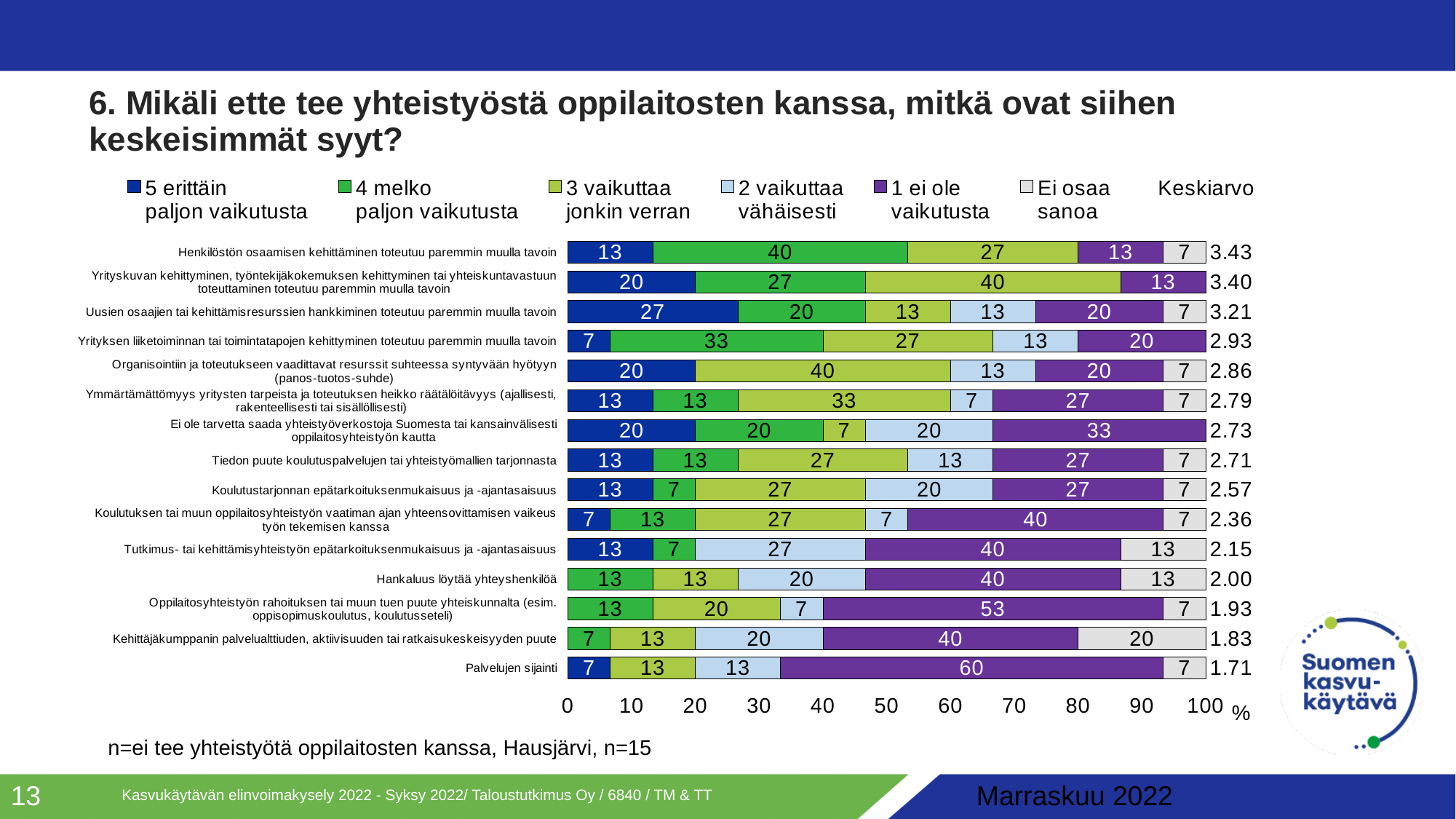
What is the difference between the Keskiarvo of 'Henkilöstön osaamisen kehittäminen toteutuu paremmin muulla tavoin' and that of 'Palvelujen sijainti'? 1.72 Which category has the highest Keskiarvo value? Henkilöstön osaamisen kehittäminen toteutuu paremmin muulla tavoin Which legend entry is shown in dark blue? 5 erittäin paljon vaikutusta How many categories (reasons) are plotted in the chart? 15 What is the value of '5 erittäin paljon vaikutusta' for 'Uusien osaajien tai kehittämisresurssien hankkiminen toteutuu paremmin muulla tavoin'? 27 Which category has the lowest Keskiarvo value? Palvelujen sijainti What kind of chart is shown on the slide? Stacked horizontal bar chart What is the value of '1 ei ole vaikutusta' for 'Palvelujen sijainti'? 60 What is the value of '4 melko paljon vaikutusta' for 'Henkilöstön osaamisen kehittäminen toteutuu paremmin muulla tavoin'? 40 What is the 'Ei osaa sanoa' value for 'Kehittäjäkumppanin palvelualttiuden, aktiivisuuden tai ratkaisukeskeisyyden puute'? 20 Which has a larger '1 ei ole vaikutusta' value: 'Palvelujen sijainti' or 'Oppilaitosyhteistyön rahoituksen tai muun tuen puute yhteiskunnalta'? Palvelujen sijainti What is the Keskiarvo value for 'Palvelujen sijainti'? 1.71